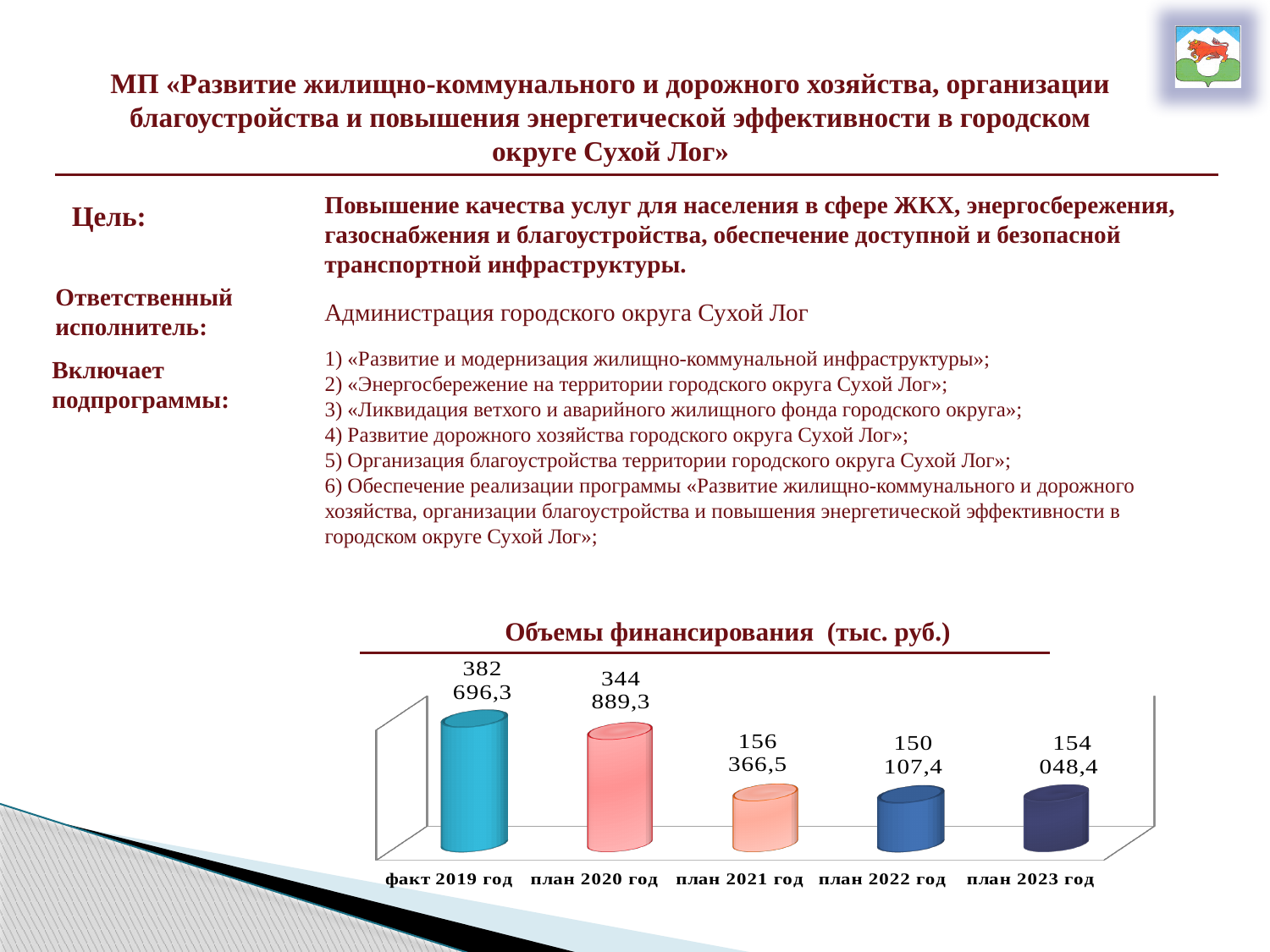
Which is larger in the chart Объемы финансирования (тыс. руб.): the value for план 2022 год or план 2023 год? план 2023 год What is the value for факт 2019 год in the chart Объемы финансирования (тыс. руб.)? 382 696,3 Do the values in the chart Объемы финансирования (тыс. руб.) rise or fall from факт 2019 год to план 2022 год? fall Which category has the lowest value in the chart Объемы финансирования (тыс. руб.)? план 2022 год How many categories are shown in the chart Объемы финансирования (тыс. руб.)? 5 What is the value for план 2021 год in the chart Объемы финансирования (тыс. руб.)? 156 366,5 What is the value for план 2023 год in the chart Объемы финансирования (тыс. руб.)? 154 048,4 What kind of chart is Объемы финансирования (тыс. руб.)? bar chart What is the title of the chart on the slide? Объемы финансирования (тыс. руб.) Which category has the highest value in the chart Объемы финансирования (тыс. руб.)? факт 2019 год What is the difference between the values for факт 2019 год and план 2020 год in the chart Объемы финансирования (тыс. руб.)? 37 807,0 What is the difference between the values for план 2021 год and план 2022 год in the chart Объемы финансирования (тыс. руб.)? 6 259,1